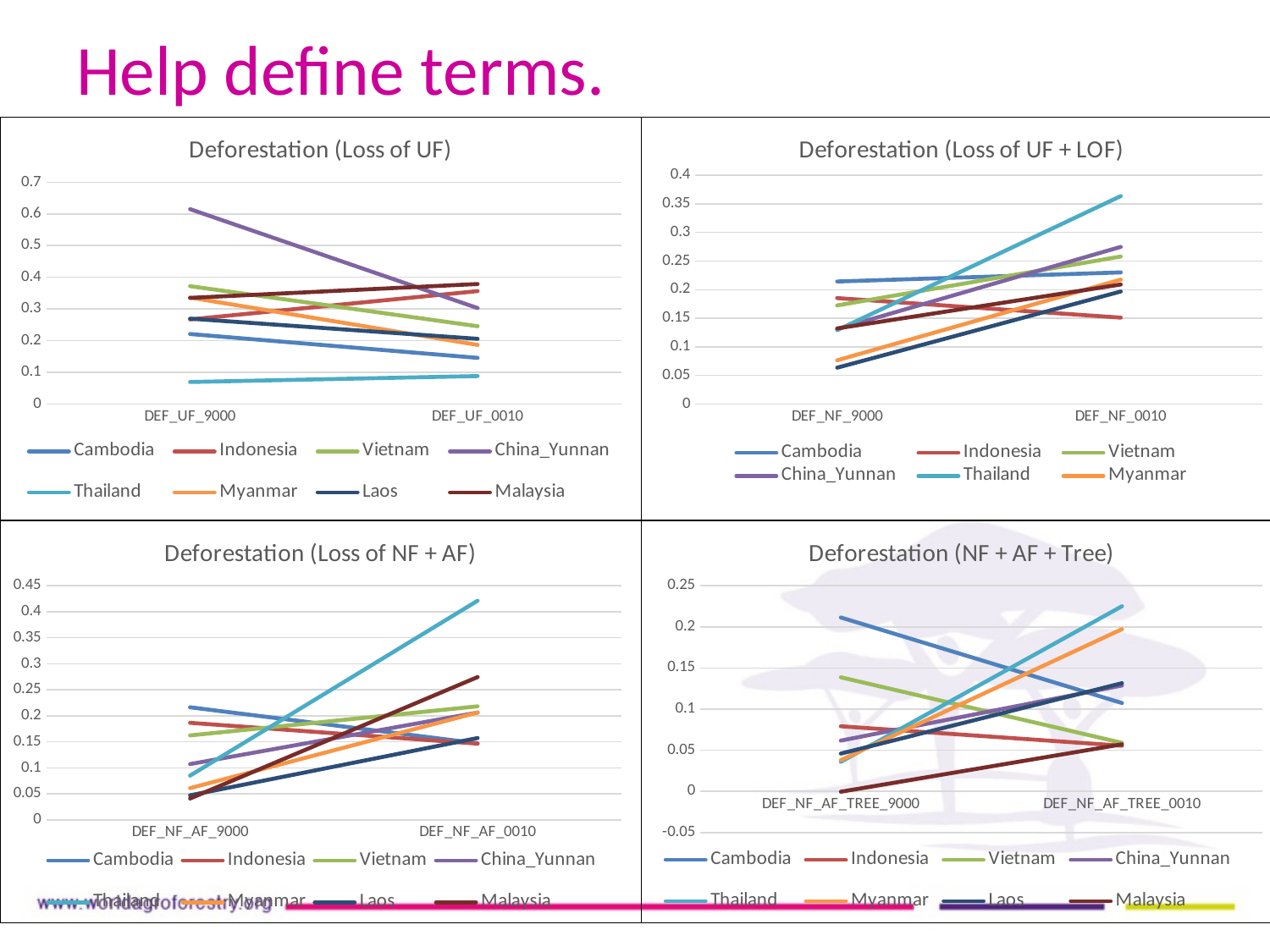
In the "Deforestation (Loss of UF)" chart, which series has the highest value at DEF_UF_9000? China_Yunnan In the "Deforestation (Loss of UF)" chart, does the China_Yunnan line rise or fall from DEF_UF_9000 to DEF_UF_0010? Fall In the "Deforestation (NF + AF + Tree)" chart, which series has the highest value at DEF_NF_AF_TREE_9000? Cambodia In the "Deforestation (Loss of UF + LOF)" chart, which series has the highest value at DEF_NF_0010? Thailand How many categories are on the x axis of the "Deforestation (Loss of NF + AF)" chart? 2 How many series does the legend of the "Deforestation (Loss of UF)" chart list? 8 In the "Deforestation (Loss of UF + LOF)" chart, is the value for Thailand at DEF_NF_0010 greater or less than 0.3? greater In the "Deforestation (Loss of UF)" chart, which series has the lowest value at DEF_UF_9000? Thailand How many series does the legend of the "Deforestation (Loss of UF + LOF)" chart list? 6 In the "Deforestation (Loss of UF)" chart, is the value for China_Yunnan at DEF_UF_9000 greater or less than 0.5? greater In the "Deforestation (Loss of NF + AF)" chart, does the Cambodia line rise or fall from DEF_NF_AF_9000 to DEF_NF_AF_0010? Fall What kind of chart is the "Deforestation (Loss of UF)" chart? Line chart